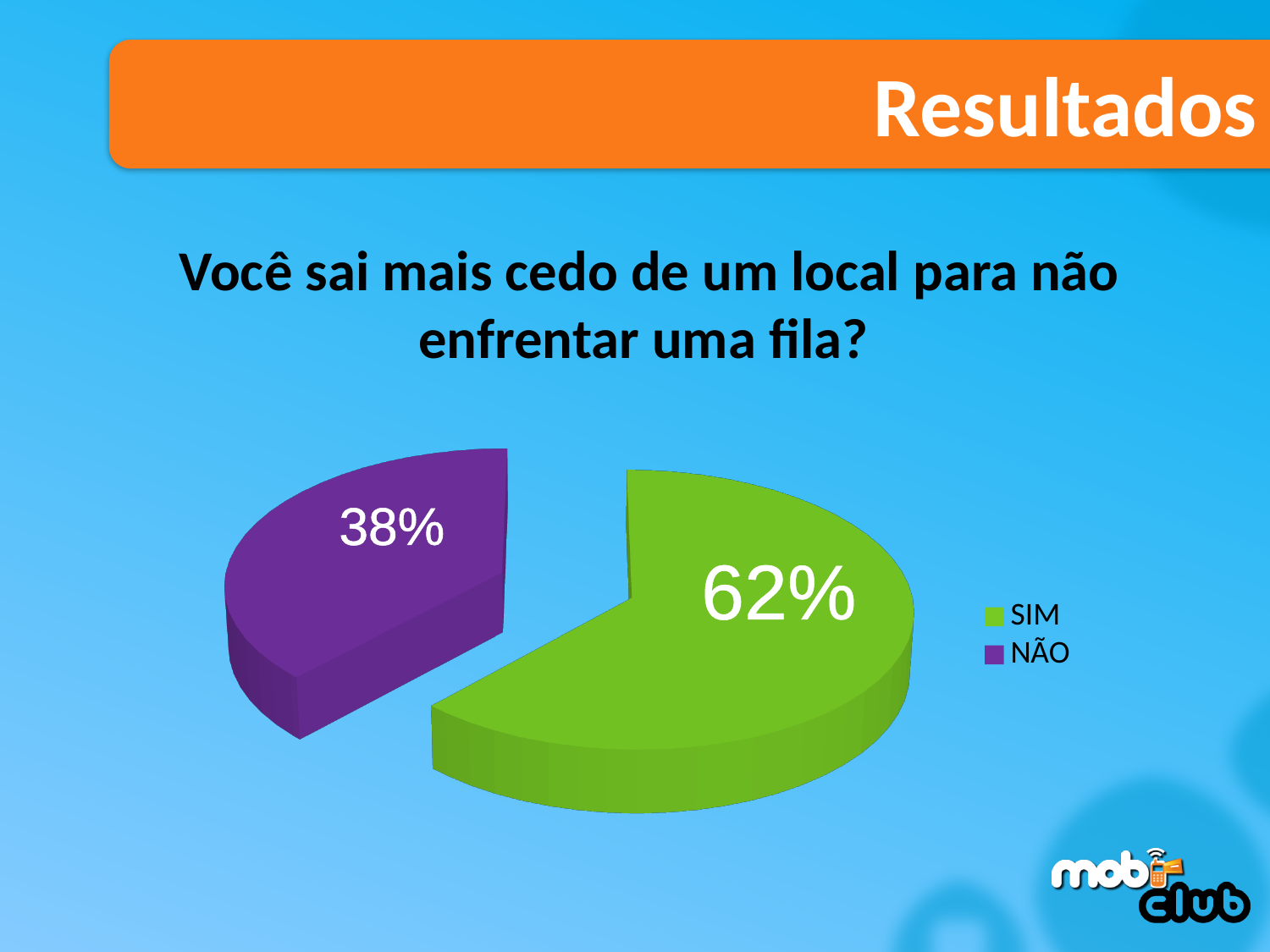
Which slice is larger, SIM or NÃO? SIM How many slices does the pie chart have? 2 What percentage of respondents answered NÃO? 38% What is the difference in percentage points between the SIM and NÃO slices? 24 What colour is the NÃO slice? purple Which response has the smallest share of the pie? NÃO What percentage of respondents answered SIM? 62% Which response has the largest share of the pie? SIM How many entries does the legend list? 2 What kind of chart is shown on the slide? pie chart What share of the pie does the SIM slice represent? 62% What question is the pie chart answering, according to the text above it? Você sai mais cedo de um local para não enfrentar uma fila?